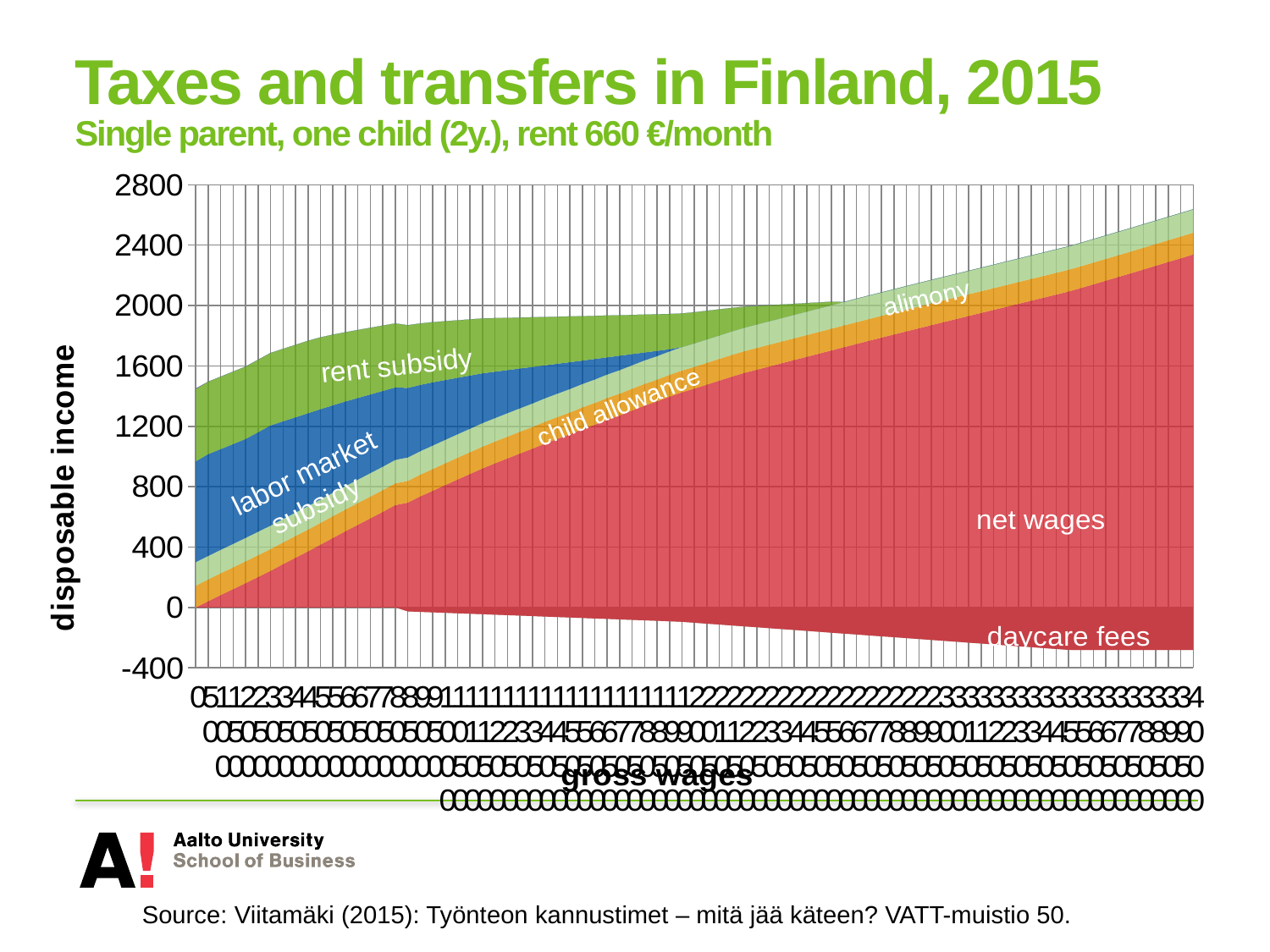
At the left edge of the chart (zero gross wages), is total disposable income greater or less than 1600? less At the left edge of the chart (zero gross wages), is total disposable income greater or less than 1200? greater At the right edge of the chart, is total disposable income greater or less than 2400? greater Which component of disposable income is plotted below zero? daycare fees Does the rent subsidy area shrink or grow as gross wages increase? shrink Which component makes up the largest share of disposable income at the highest gross wages shown? net wages Does the net wages area rise or fall as gross wages increase along the x axis? rise What is the title of the chart on the slide? Taxes and transfers in Finland, 2015 What kind of chart is shown on the slide? stacked area chart What is the label of the vertical axis? disposable income Does the labor market subsidy area shrink or grow as gross wages increase? shrink How many labelled components (series) are shown in the stacked area chart? 6